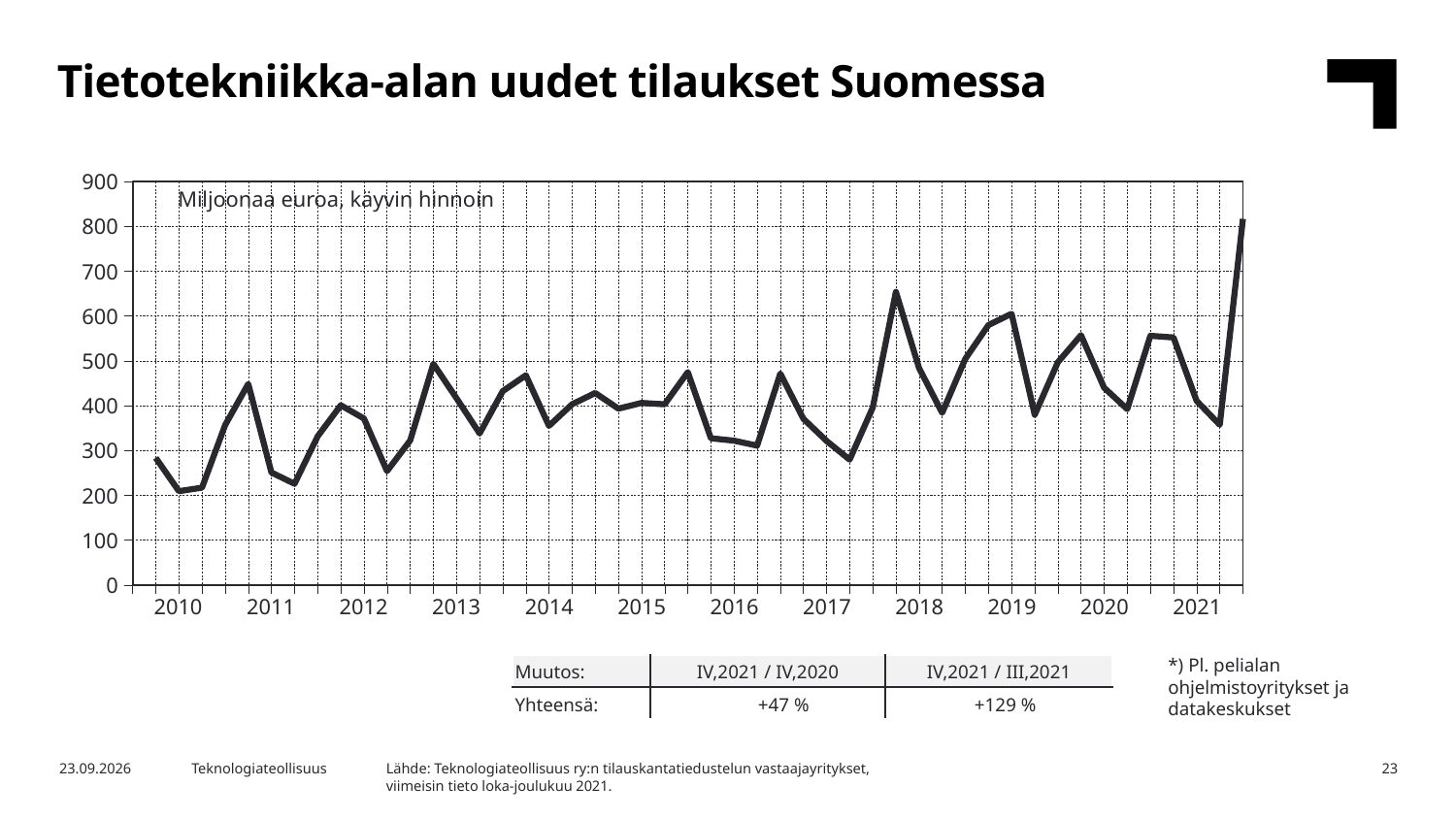
According to the table below the chart, what is the change for IV,2021 / IV,2020? +47 % According to the table below the chart, what is the change for IV,2021 / III,2021? +129 % In which year does the line reach its highest value? 2021 Overall, does the line rise or fall from 2010 to the end of 2021? rise What unit label is printed inside the chart area? Miljoonaa euroa, käyvin hinnoin What is the title of the chart? Tietotekniikka-alan uudet tilaukset Suomessa Is the lowest value in 2010 greater or less than 300? less Is the value at the last point of the line (end of 2021) greater or less than 700? greater What kind of chart is shown on the slide? line chart How many years are labelled on the x axis? 12 Is the lowest value in 2016 greater or less than 400? less